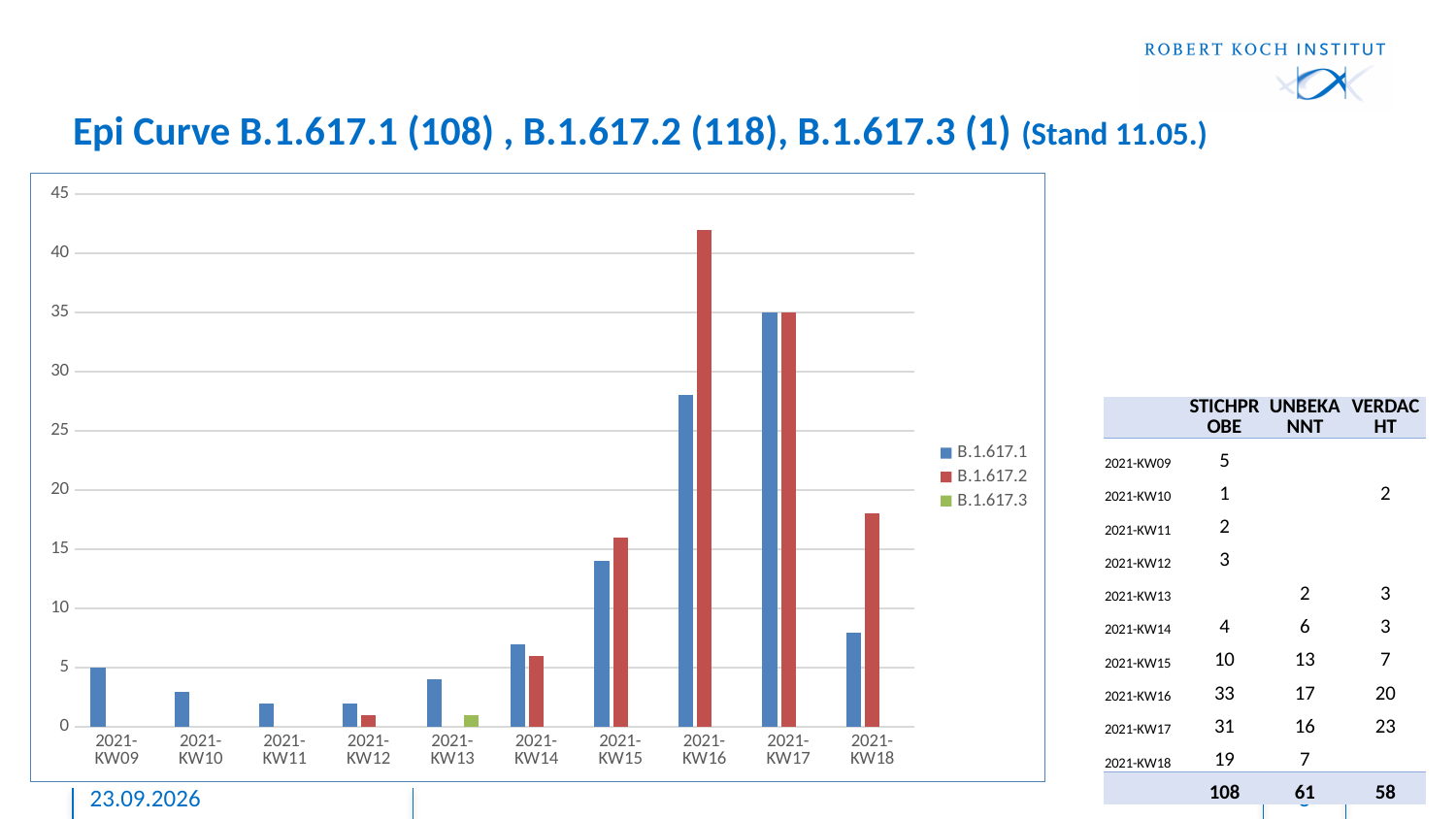
Which series is shown in green in the legend? B.1.617.3 In which week is the B.1.617.2 bar highest? 2021-KW16 In which week is the B.1.617.1 bar highest? 2021-KW17 What kind of chart is shown on the slide? bar chart Is the value for B.1.617.2 in 2021-KW18 greater or less than 15? greater Is the value for B.1.617.2 in 2021-KW16 greater or less than 40? greater How many series does the legend list? 3 Is the value for B.1.617.1 in 2021-KW16 greater or less than 30? less Do the B.1.617.2 values rise or fall from 2021-KW14 to 2021-KW16? rise In 2021-KW18, which series has the larger bar, B.1.617.1 or B.1.617.2? B.1.617.2 How many calendar weeks (categories) are shown on the x axis? 10 In 2021-KW16, which series has the larger bar, B.1.617.1 or B.1.617.2? B.1.617.2